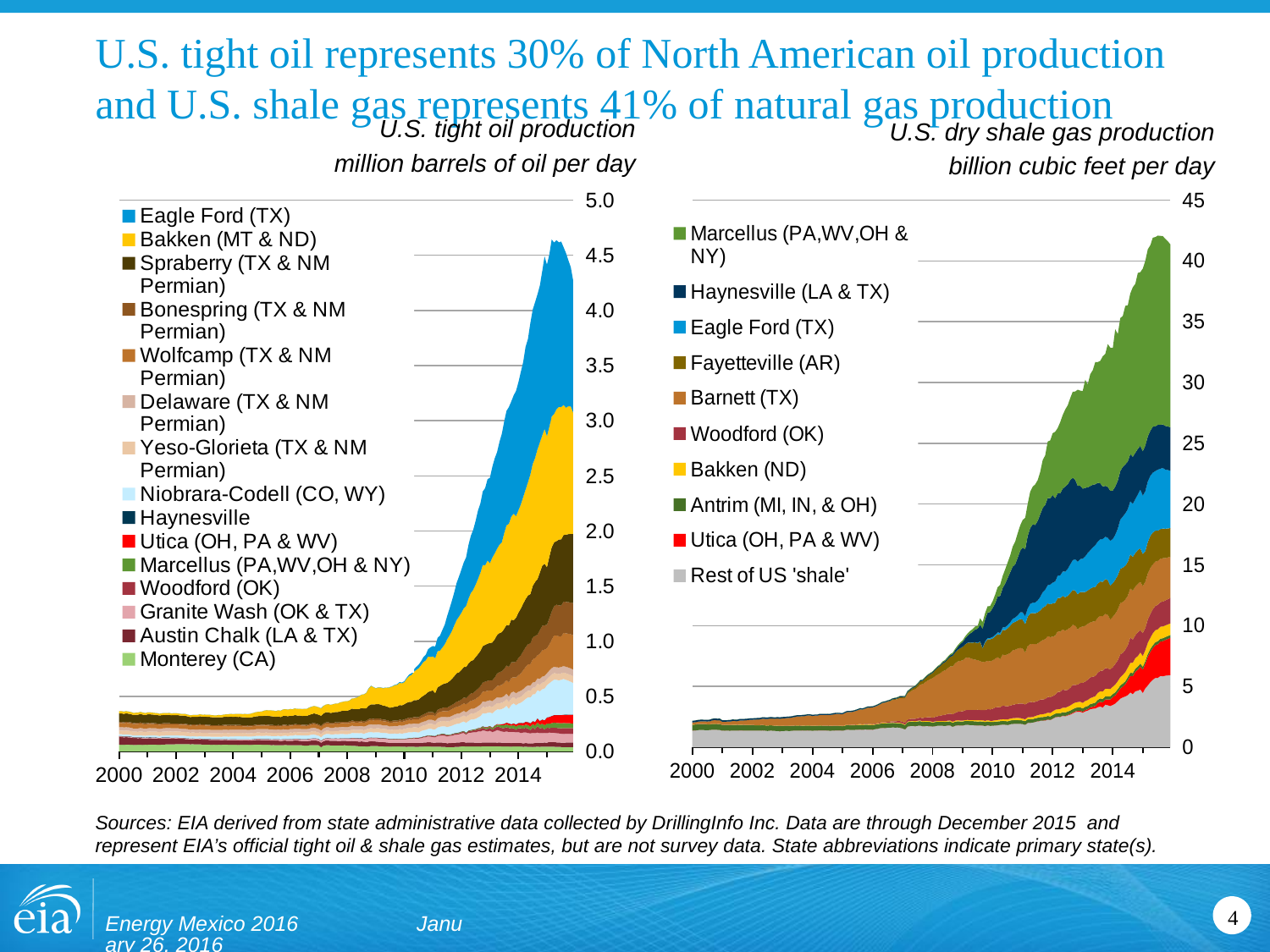
How many series does the legend of the U.S. dry shale gas production chart list? 10 In the U.S. tight oil production chart, is the total production in 2008 greater or less than 1.0 million barrels per day? less In the U.S. tight oil production chart, is the total production at the end of 2015 greater or less than 4.0 million barrels per day? greater In the U.S. dry shale gas production chart, which play contributes the largest share of production at the end of 2015? Marcellus (PA,WV,OH & NY) In the U.S. dry shale gas production chart, is the total production in 2008 greater or less than 10 billion cubic feet per day? less In the U.S. dry shale gas production chart, do total values rise or fall from 2000 to 2015? Rise What unit is used on the U.S. dry shale gas production chart? billion cubic feet per day What unit is used on the U.S. tight oil production chart? million barrels of oil per day How many series does the legend of the U.S. tight oil production chart list? 15 What kind of chart is the U.S. tight oil production chart on the left? Stacked area chart In the U.S. tight oil production chart, do total values rise or fall from 2000 to 2015? Rise